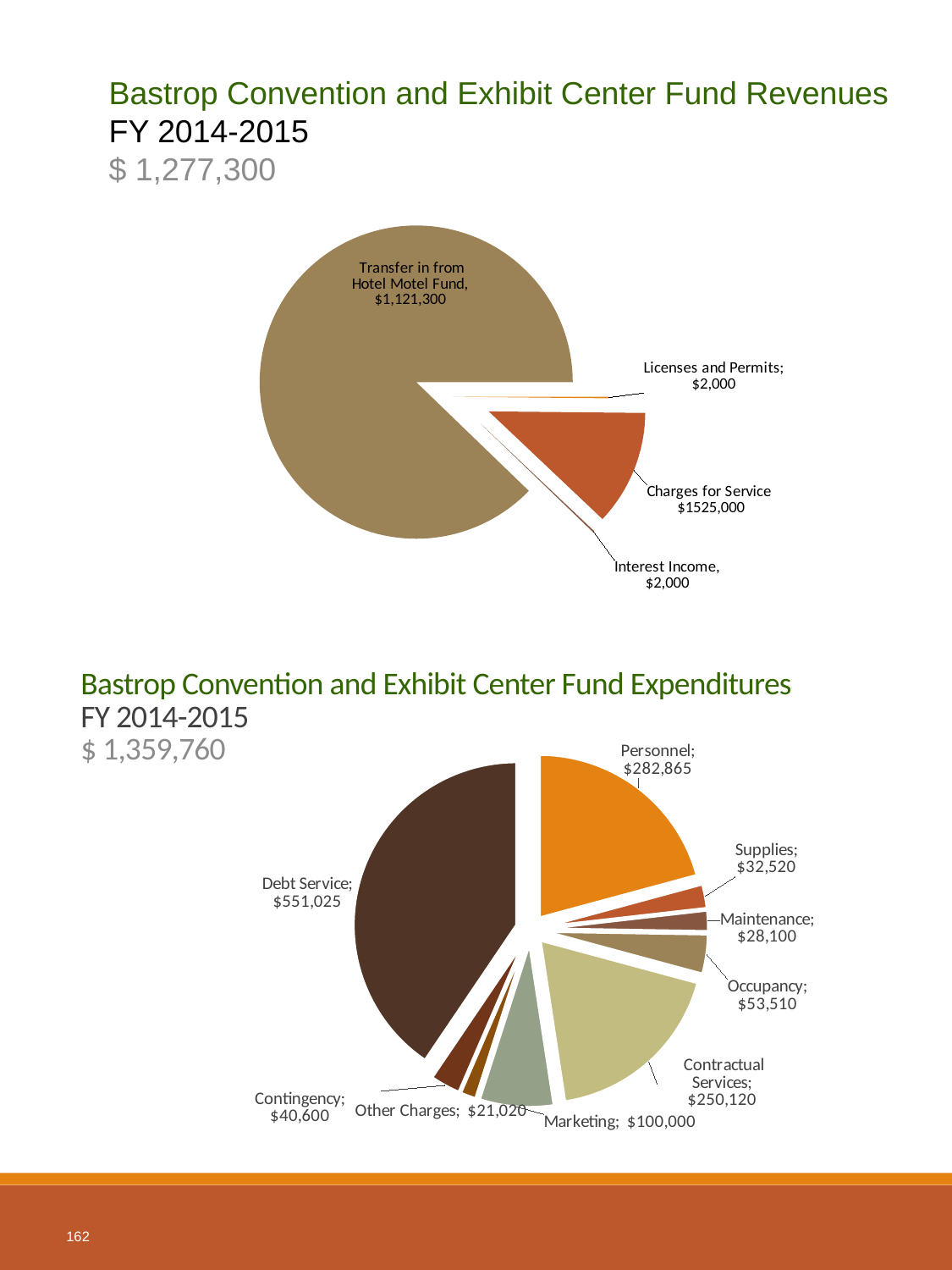
How many categories are shown in the Expenditures pie chart? 9 In the Expenditures pie chart, which category has the smallest slice? Other Charges In the Expenditures pie chart, which is larger: Personnel or Marketing? Personnel How many slices does the Revenues pie chart have? 4 In the Expenditures pie chart, what is the value for Contractual Services? $250,120 What total amount is shown under the Expenditures chart title? $ 1,359,760 In the Expenditures pie chart, what is the difference between Occupancy and Maintenance? $25,410 What kind of chart is used for the Bastrop Convention and Exhibit Center Fund Revenues? Pie chart In the Revenues pie chart, which category has the largest slice? Transfer in from Hotel Motel Fund In the Revenues pie chart, what is the value for Interest Income? $2,000 In the Revenues pie chart, what is the value for Transfer in from Hotel Motel Fund? $1,121,300 In the Expenditures pie chart, what is the value for Debt Service? $551,025